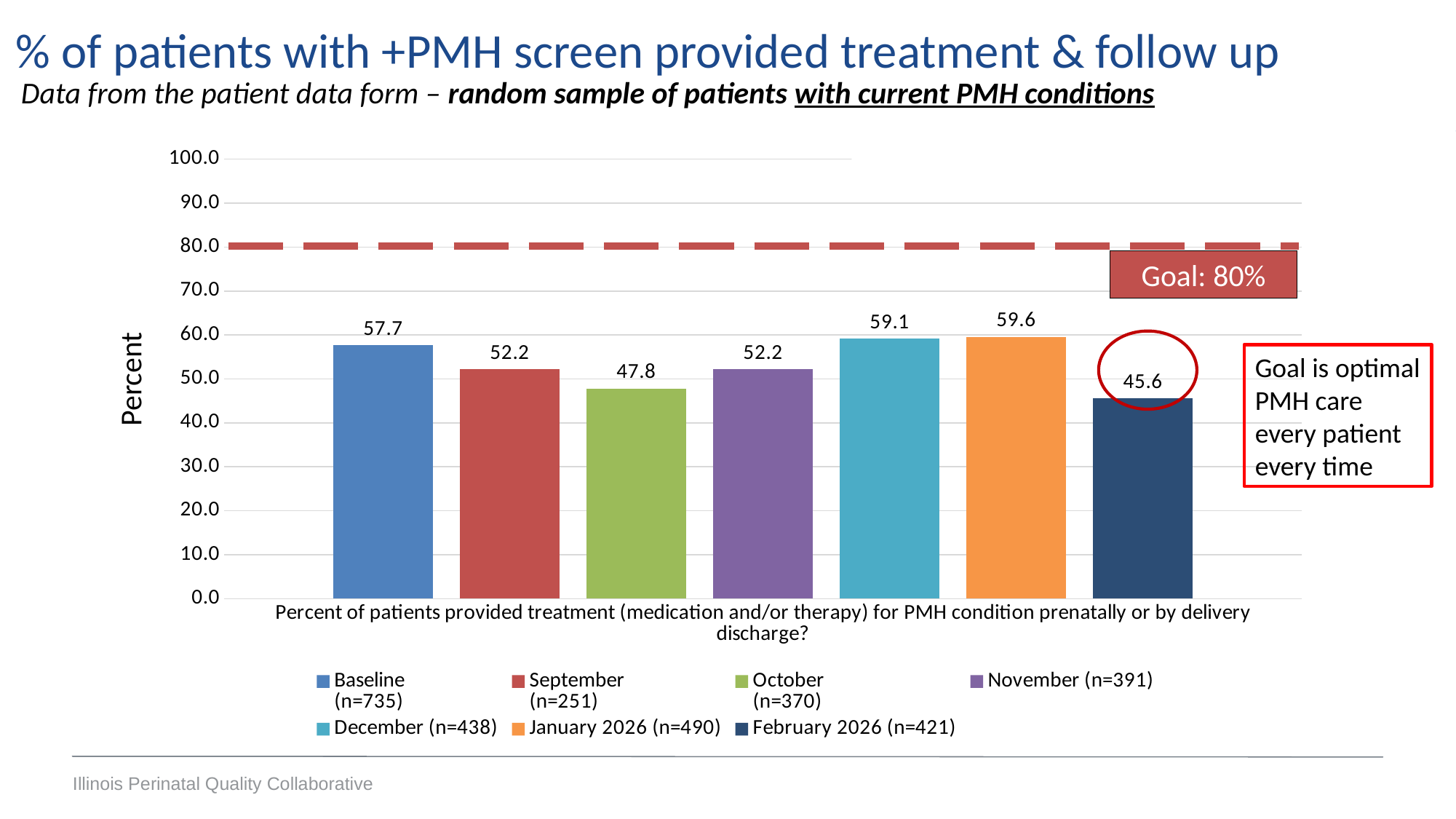
What is the value for October (n=370)? 47.8 How many series does the legend list? 7 What is the y-axis label of the chart? Percent Which is larger, the value for Baseline or the value for December? December Which series has the lowest value? February 2026 (n=421) What is the value for February 2026 (n=421)? 45.6 Which series has the highest value? January 2026 (n=490) What goal percentage is marked by the dashed line on the chart? 80% Is the value for November greater or less than 60.0? less What kind of chart is shown on the slide? bar chart What is the value for Baseline (n=735)? 57.7 What is the difference between the January 2026 value and the February 2026 value? 14.0